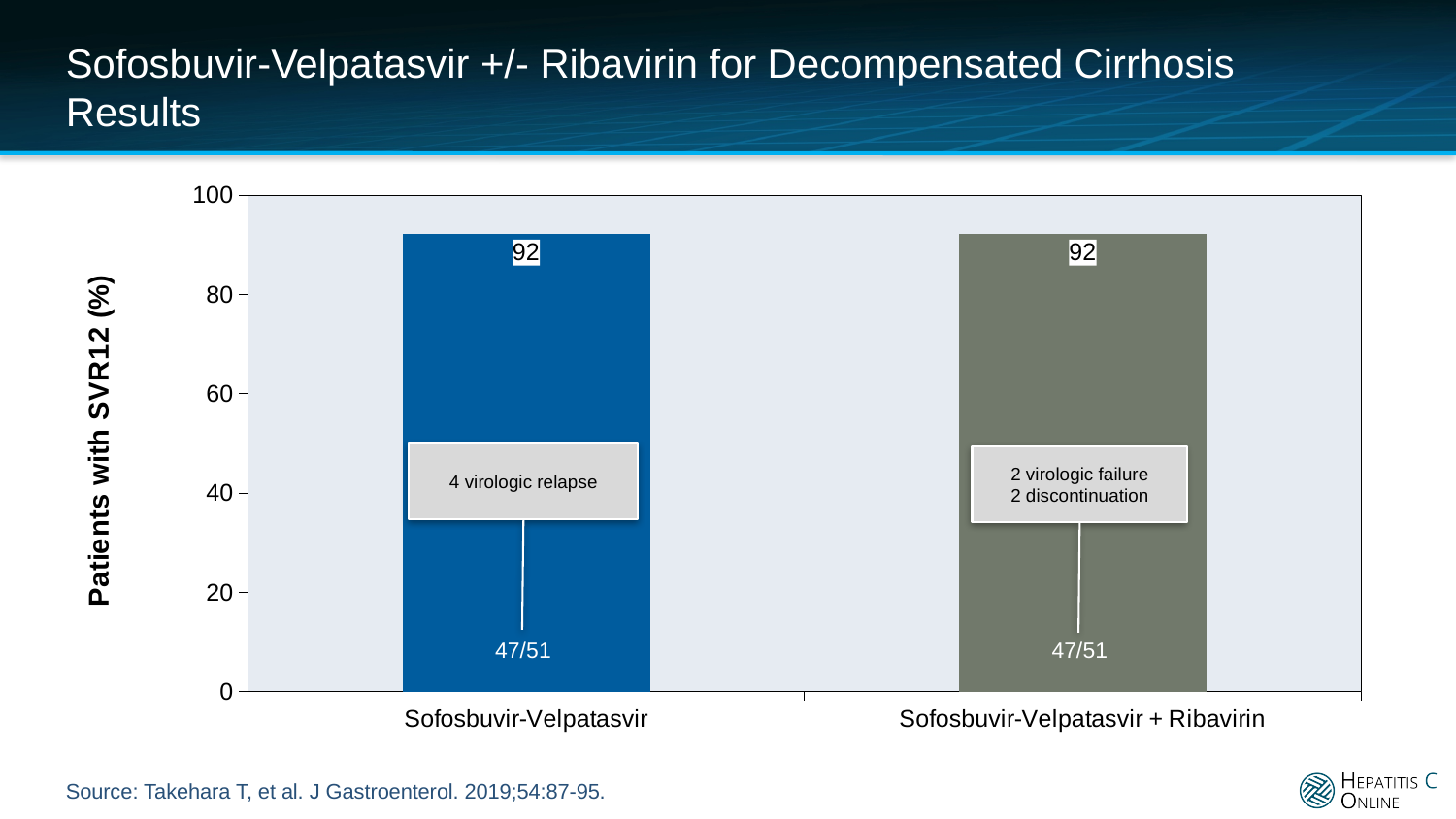
What fraction of patients achieved SVR12 in the Sofosbuvir-Velpatasvir group? 47/51 According to the annotation on the chart, how many virologic relapses occurred in the Sofosbuvir-Velpatasvir group? 4 What is the SVR12 rate for Sofosbuvir-Velpatasvir? 92 What kind of chart is shown on the slide? Bar chart What fraction of patients achieved SVR12 in the Sofosbuvir-Velpatasvir + Ribavirin group? 47/51 How many treatment groups are shown on the chart? 2 What is the difference between the SVR12 values for Sofosbuvir-Velpatasvir and Sofosbuvir-Velpatasvir + Ribavirin? 0 Is the value for Sofosbuvir-Velpatasvir + Ribavirin greater or less than 100? less Is the value for Sofosbuvir-Velpatasvir greater or less than 80? greater What is the label on the y-axis of the chart? Patients with SVR12 (%) What is the SVR12 rate for Sofosbuvir-Velpatasvir + Ribavirin? 92